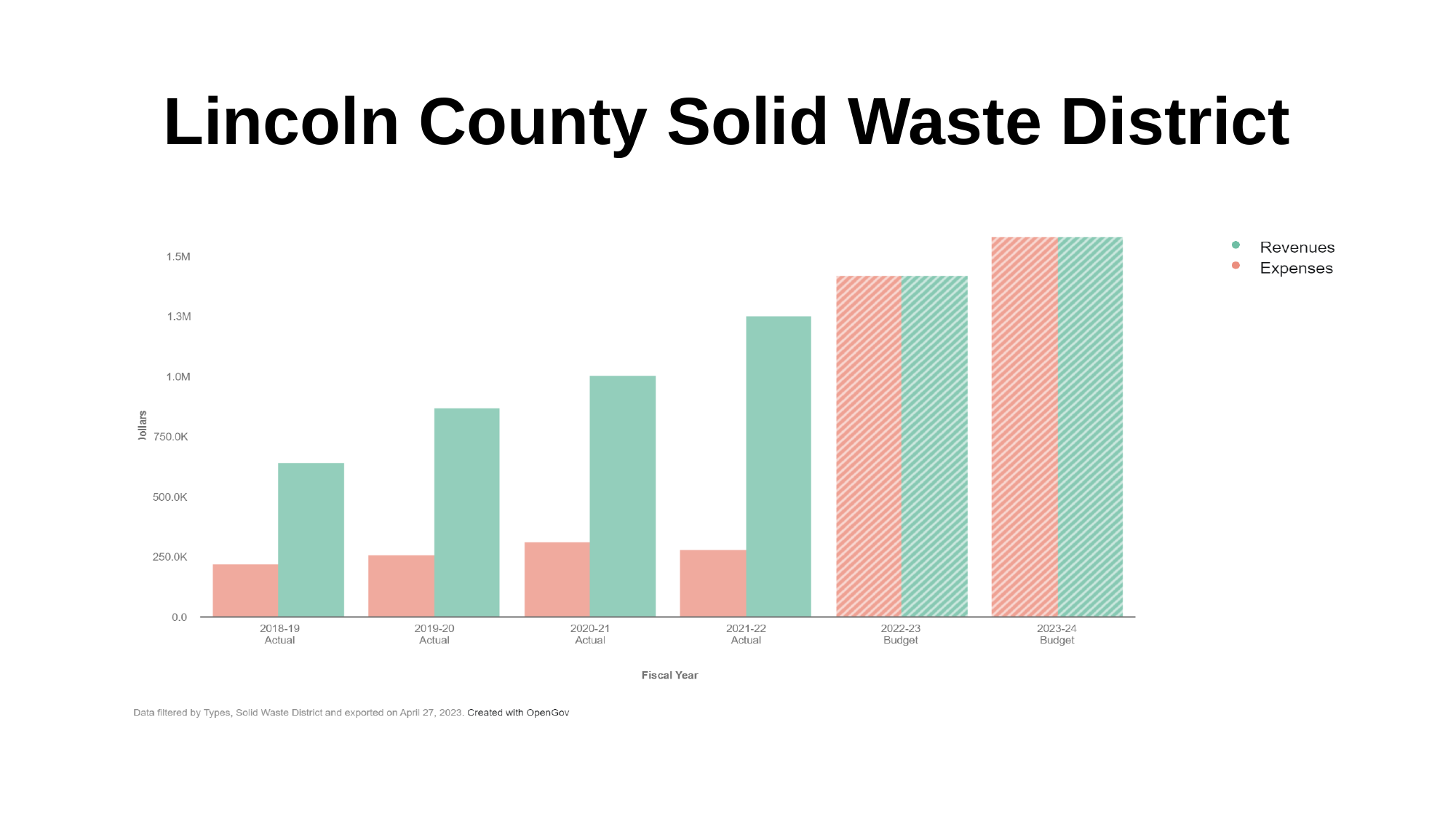
Which fiscal year has the lowest Expenses bar? 2018-19 Actual For 2020-21 Actual, which is larger, Revenues or Expenses? Revenues How many series does the legend list? 2 Do the Revenues values rise or fall from 2018-19 Actual to 2023-24 Budget? Rise Is the Revenues value for 2019-20 Actual greater or less than 750.0K? greater How many fiscal year categories are shown on the x axis? 6 Is the Expenses value for 2021-22 Actual greater or less than 500.0K? less What is the title of the x axis? Fiscal Year Which fiscal year has the highest Revenues bar? 2023-24 Budget What kind of chart is shown on the slide? Bar chart Which fiscal year has the lowest Revenues bar? 2018-19 Actual Is the Revenues value for 2018-19 Actual greater or less than 500.0K? greater